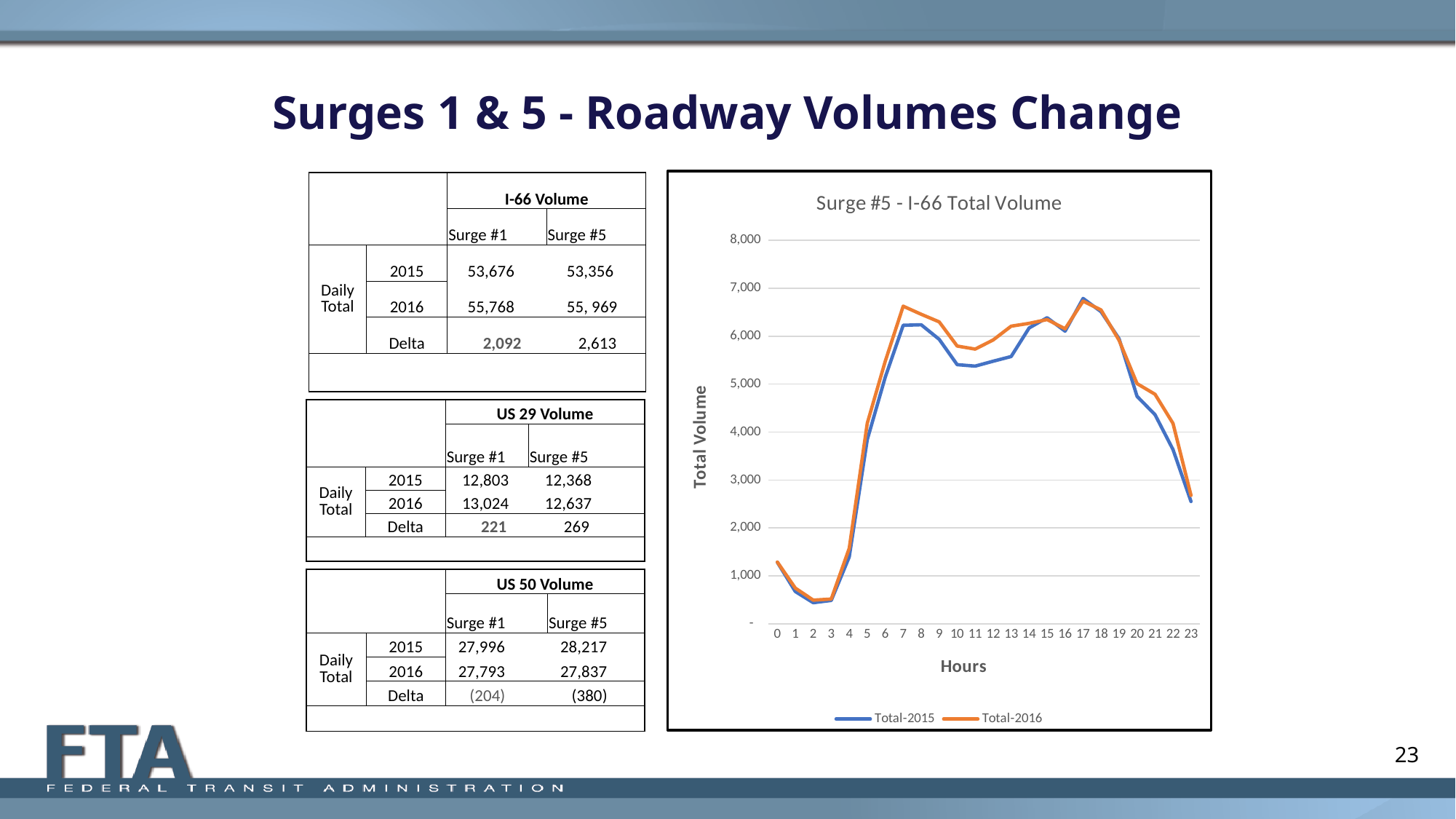
Is the Total-2016 value at hour 7 greater or less than 6,000? greater How many series does the legend of the chart list? 2 At which hour does the Total-2015 series reach its highest value? 17 What is the title of the chart? Surge #5 - I-66 Total Volume At hour 10, which series has the higher value, Total-2015 or Total-2016? Total-2016 What are the names of the two series in the chart legend? Total-2015 and Total-2016 How many hours are plotted along the x axis of the chart? 24 Do the values of the Total-2016 series rise or fall from hour 18 to hour 23? fall Is the Total-2015 value at hour 2 greater or less than 1,000? less What kind of chart is shown on the slide? line chart Is the Total-2016 value at hour 21 greater or less than 4,000? greater